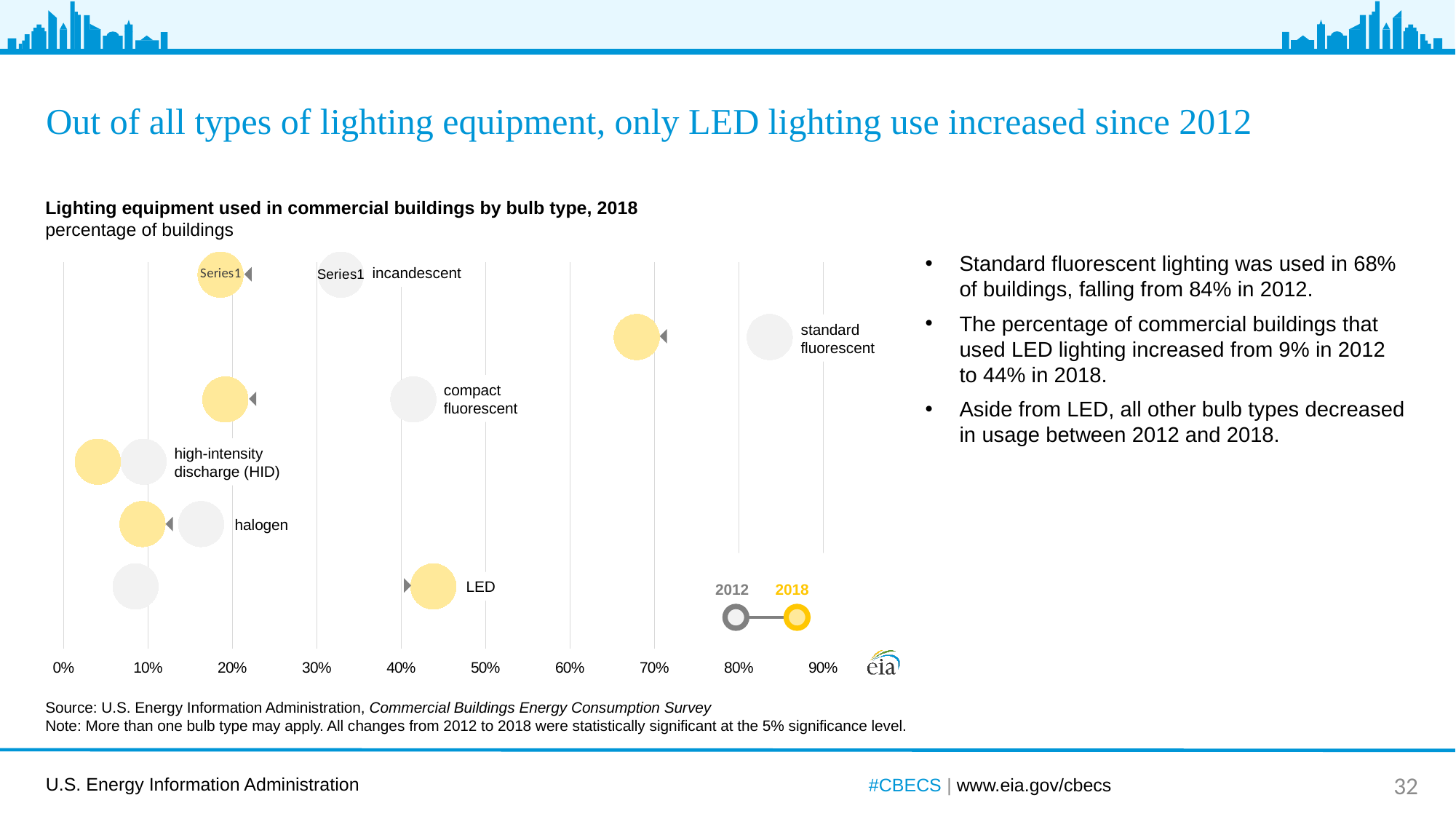
What percentage of buildings used standard fluorescent lighting in 2018? 68% What kind of chart is shown on the slide? dot plot Which bulb type has the lowest 2018 value in the chart? high-intensity discharge (HID) By how many percentage points did standard fluorescent use fall from 2012 to 2018? 16 percentage points How many series does the chart's legend list? 2 Which is larger in 2018: the value for LED or the value for compact fluorescent? LED Which bulb type has the highest 2018 value in the chart? standard fluorescent How many bulb types are plotted in the chart? 6 What percentage of buildings used LED lighting in 2012? 9% What are the two series shown in the chart's legend? 2012 and 2018